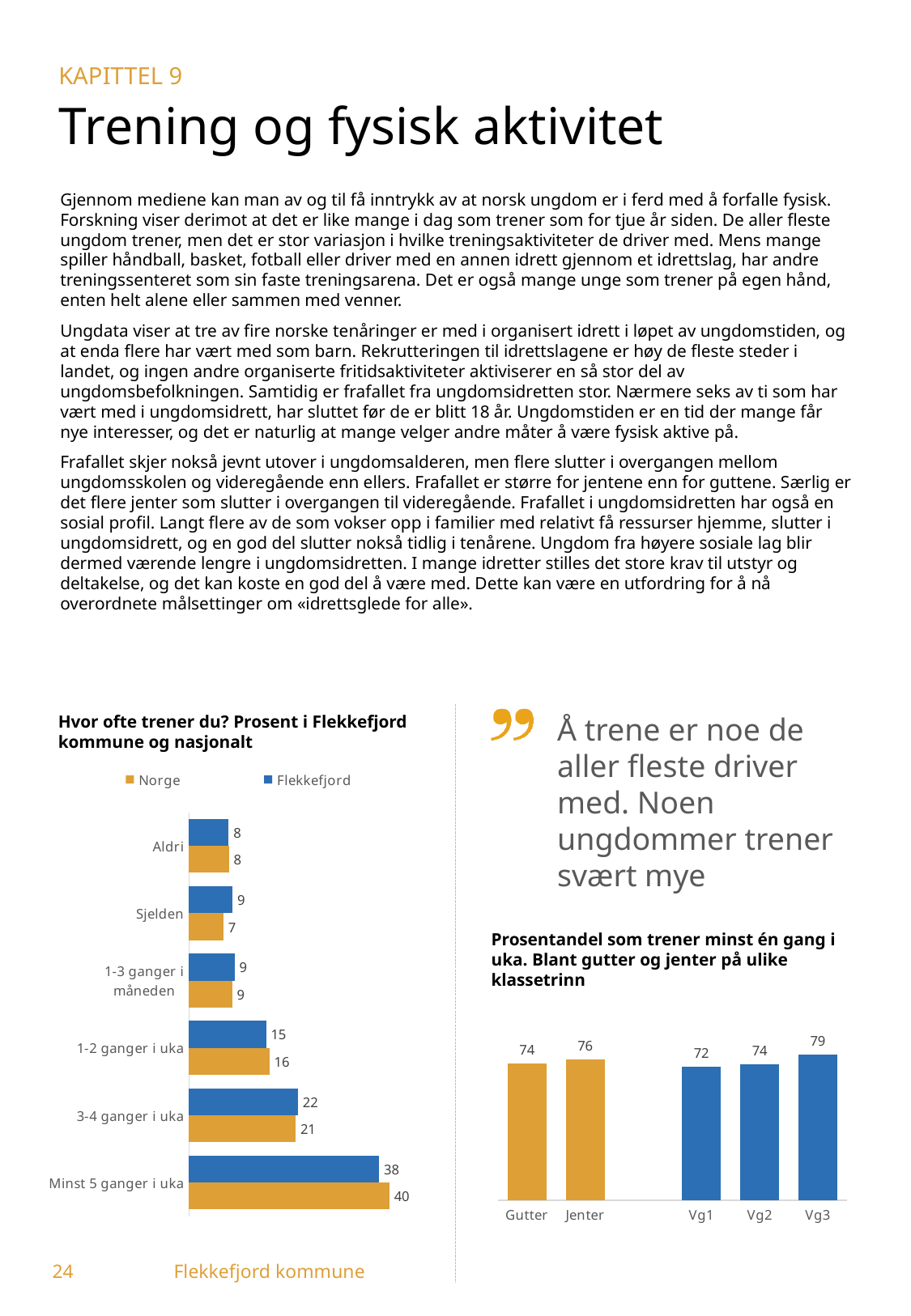
In the chart 'Hvor ofte trener du?', what is the value for Flekkefjord for 'Minst 5 ganger i uka'? 38 In the chart 'Hvor ofte trener du?', what is the difference between Norge and Flekkefjord for 'Minst 5 ganger i uka'? 2 In the chart 'Hvor ofte trener du?', how many series does the legend list? 2 In the chart 'Prosentandel som trener minst én gang i uka', what is the difference between Jenter and Gutter? 2 In the chart 'Hvor ofte trener du?', how many categories are shown? 6 In the chart 'Hvor ofte trener du?', which category has the highest value for Norge? Minst 5 ganger i uka In the chart 'Hvor ofte trener du?', which is larger for '3-4 ganger i uka', Flekkefjord or Norge? Flekkefjord What kind of chart is 'Hvor ofte trener du?'? Bar chart In the chart 'Hvor ofte trener du?', what is the value for Norge for 'Sjelden'? 7 In the chart 'Prosentandel som trener minst én gang i uka', which category has the lowest value? Vg1 In the chart 'Prosentandel som trener minst én gang i uka', what is the value for Vg3? 79 In the chart 'Prosentandel som trener minst én gang i uka', do the values rise or fall from Vg1 to Vg3? Rise